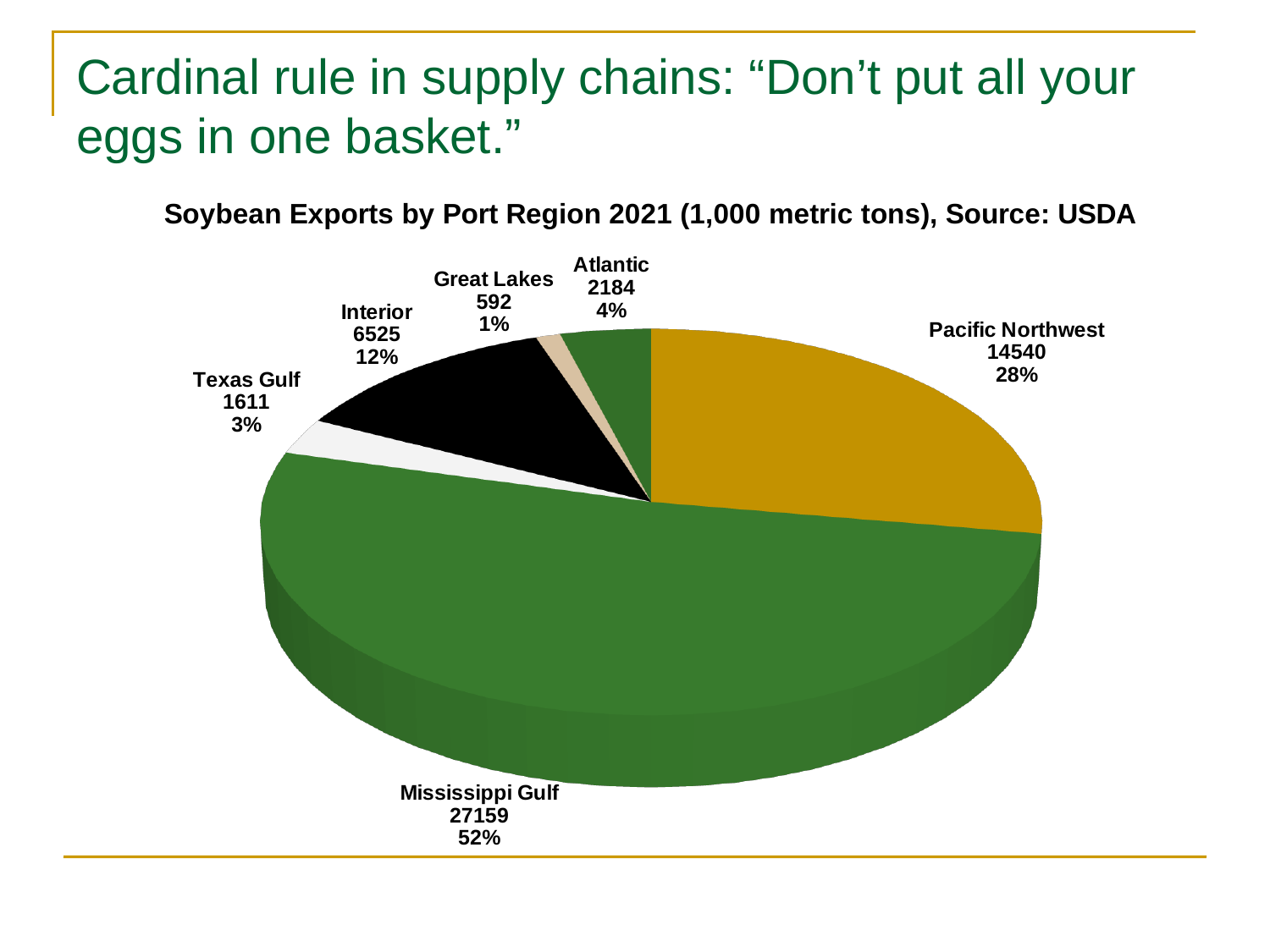
What is the value for Pacific Northwest? 14540 Which port region has the largest share of soybean exports? Mississippi Gulf What share of the pie does Texas Gulf represent? 3% What is the value for Great Lakes? 592 Which is larger, the value for Atlantic or the value for Texas Gulf? Atlantic Which port region has the smallest share of soybean exports? Great Lakes What is the difference between the values for Mississippi Gulf and Pacific Northwest? 12619 What is the value for Interior? 6525 What is the value for Mississippi Gulf? 27159 What type of chart is shown on the slide? Pie chart How many port regions are shown in the pie chart? 6 What share of the pie does Pacific Northwest represent? 28%